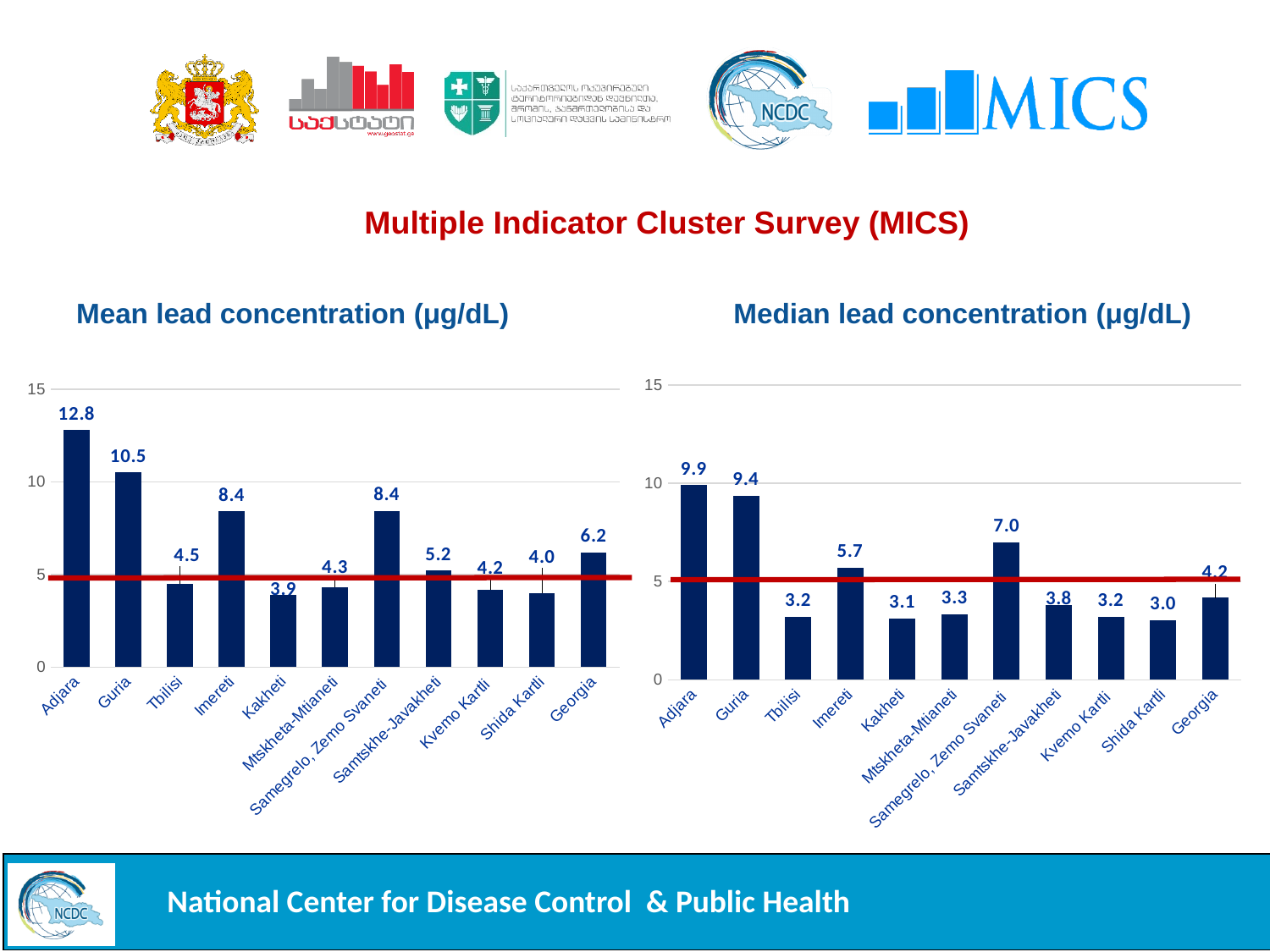
In the Median lead concentration chart, which region has the highest value? Adjara In the Median lead concentration chart, what is the value for Samegrelo, Zemo Svaneti? 7.0 In the Mean lead concentration chart, which is larger, the value for Tbilisi or the value for Mtskheta-Mtianeti? Tbilisi In the Mean lead concentration chart, which region has the lowest value? Kakheti In the Median lead concentration chart, what is the difference between the values for Imereti and Tbilisi? 2.5 In the Median lead concentration chart, is the value for Guria greater or less than 5? greater What type of chart is the Median lead concentration chart? Bar chart How many regions are shown on the x axis of the Mean lead concentration chart? 11 In the Median lead concentration chart, which region has the lowest value? Shida Kartli In the Mean lead concentration chart, what is the value for Adjara? 12.8 In the Mean lead concentration chart, what is the difference between the values for Adjara and Guria? 2.3 In the Mean lead concentration chart, what is the value for Georgia? 6.2